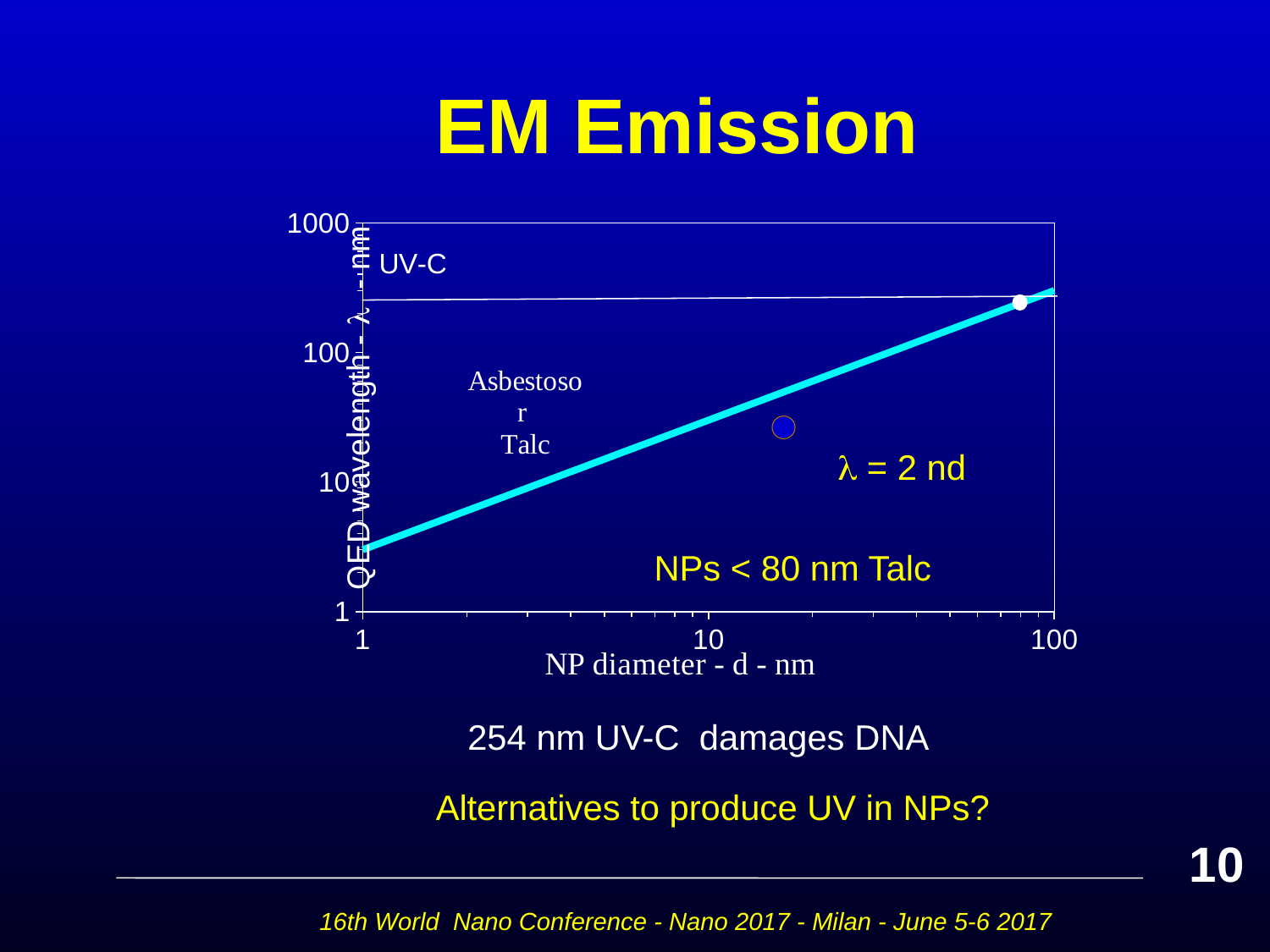
Does the QED wavelength rise or fall as the NP diameter increases along the x axis? rise What is the label of the x axis of the chart? NP diameter - d - nm Is the QED wavelength at an NP diameter of 1 nm greater or less than 10 nm? less Is the NP diameter of the white point on the line greater or less than 10 nm? greater Is the QED wavelength at an NP diameter of 10 nm greater or less than 10 nm? greater What is the largest value shown on the y axis of the chart? 1000 Which is larger, the QED wavelength at an NP diameter of 100 nm or at 1 nm? 100 nm What is the title of the chart on the slide? EM Emission What kind of chart is shown on the slide? line chart